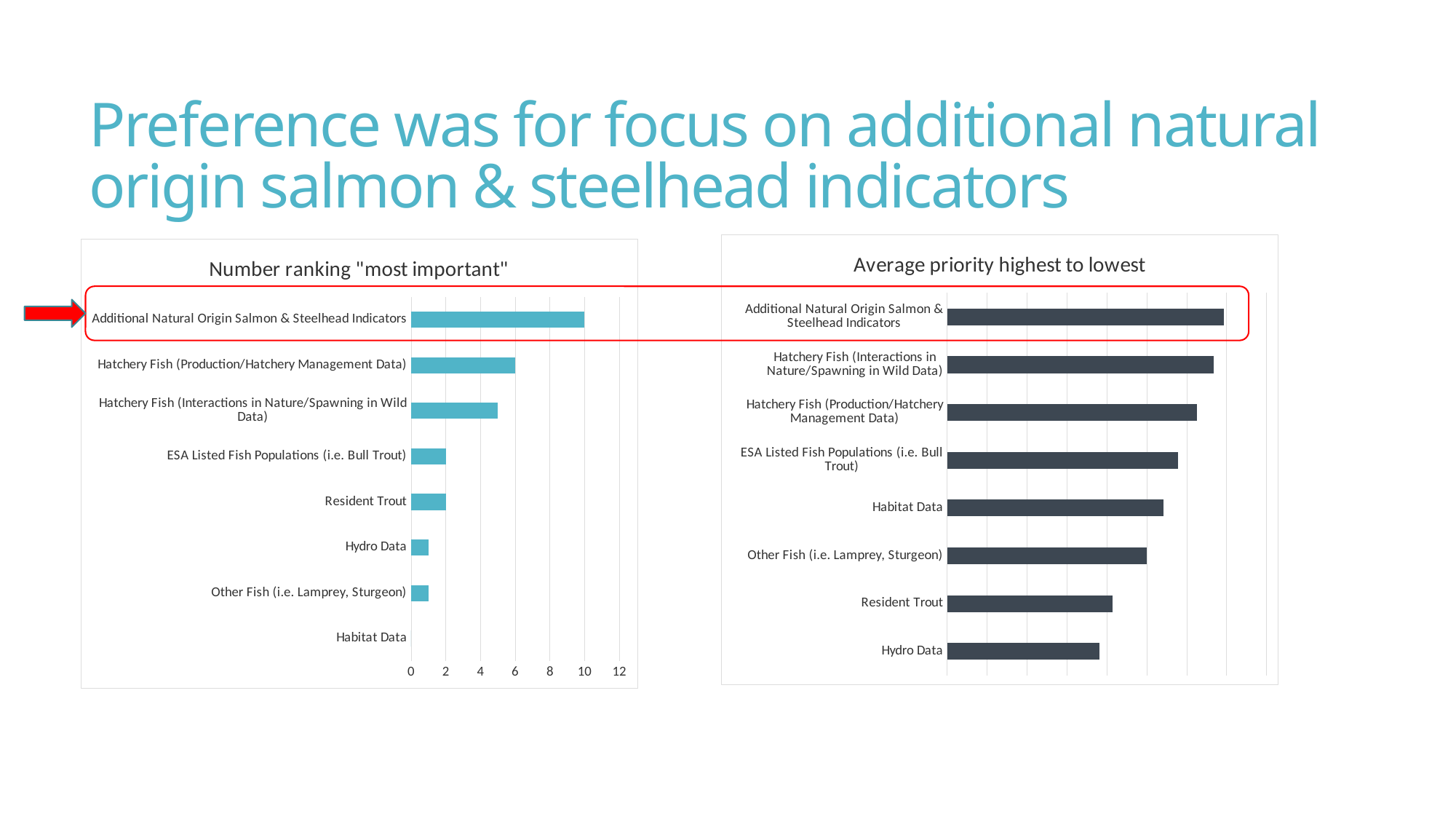
In the left chart "Number ranking "most important"", what is the value for Additional Natural Origin Salmon & Steelhead Indicators? 10 In the right chart "Average priority highest to lowest", which category has the longest bar? Additional Natural Origin Salmon & Steelhead Indicators In the left chart "Number ranking "most important"", what is the value for Habitat Data? 0 In the right chart "Average priority highest to lowest", which category has the shortest bar? Hydro Data In the left chart "Number ranking "most important"", which category has the highest value? Additional Natural Origin Salmon & Steelhead Indicators In the left chart "Number ranking "most important"", which category has the lowest value? Habitat Data What kind of chart is the left chart titled "Number ranking "most important""? bar chart In the left chart "Number ranking "most important"", what is the difference between the values for Additional Natural Origin Salmon & Steelhead Indicators and Hatchery Fish (Production/Hatchery Management Data)? 4 In the left chart "Number ranking "most important"", how many categories are shown? 8 In the left chart "Number ranking "most important"", what is the value for Hatchery Fish (Production/Hatchery Management Data)? 6 In the right chart "Average priority highest to lowest", which has the larger value, Resident Trout or Hydro Data? Resident Trout In the left chart "Number ranking "most important"", is the value for Hatchery Fish (Interactions in Nature/Spawning in Wild Data) greater or less than 4? greater